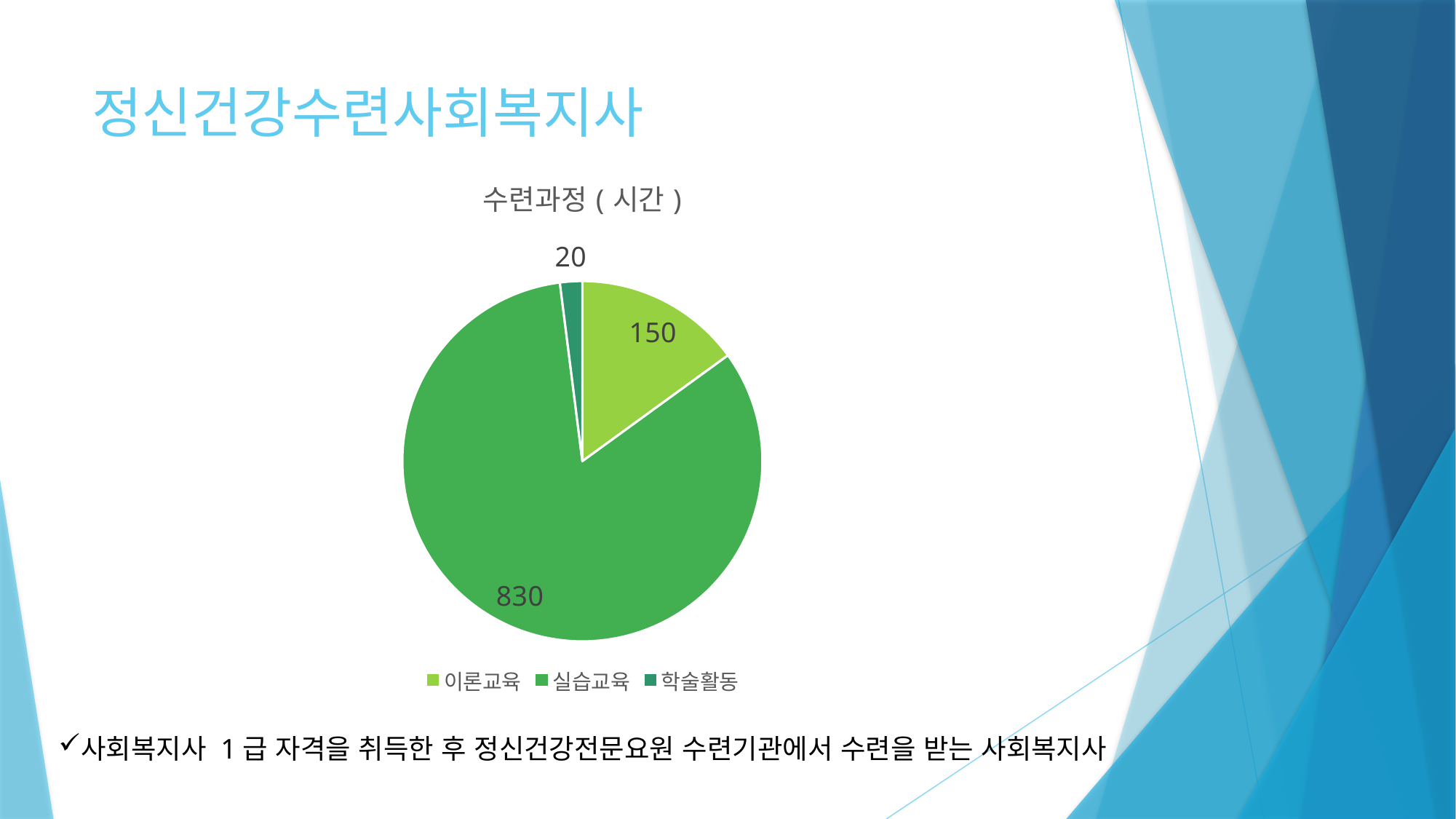
What is the total of all slices in the pie chart? 1000 What is the value for 학술활동? 20 What share of the pie does 실습교육 represent? 83% What kind of chart is shown on the slide? pie chart Which category has the largest slice of the pie? 실습교육 What is the difference between the values for 실습교육 and 이론교육? 680 Which category has the smallest slice of the pie? 학술활동 How many slices does the pie chart have? 3 What is the title of the chart? 수련과정 ( 시간 ) Which is larger, the value for 이론교육 or the value for 학술활동? 이론교육 What is the value for 이론교육? 150 What is the value for 실습교육? 830